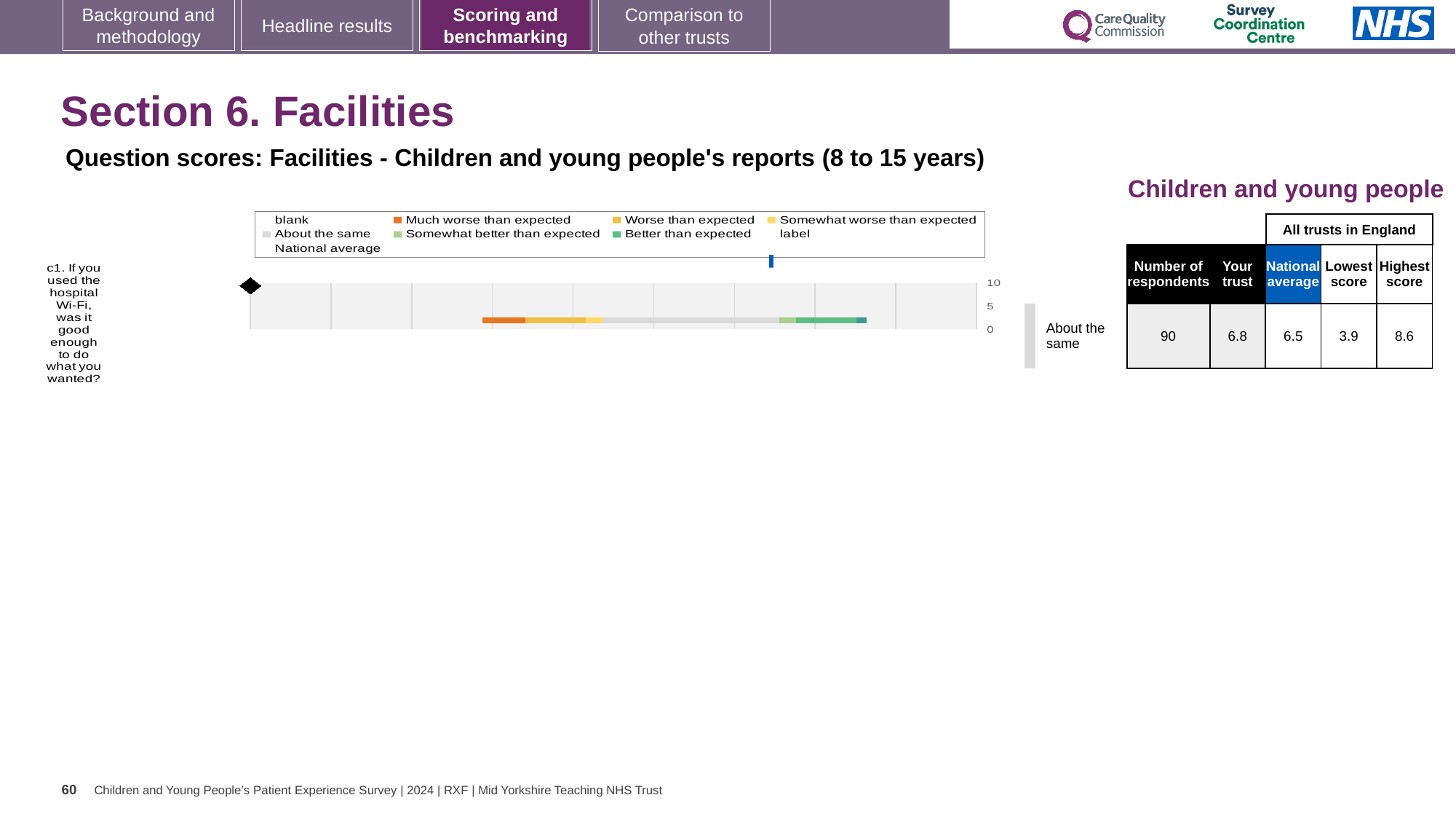
According to the table beside the chart, what is the 'Your trust' score for c1? 6.8 Which legend entry is shown in orange? Much worse than expected Which is larger for c1: the 'Your trust' score or the national average? Your trust What is the highest tick value shown on the chart's score axis? 10 Which benchmark category is the trust's result for c1 placed in? About the same According to the table beside the chart, what is the lowest score among all trusts in England for c1? 3.9 What kind of chart is used to show the question score for c1? bar chart What is the label of the question plotted on the chart? c1. If you used the hospital Wi-Fi, was it good enough to do what you wanted? According to the table beside the chart, how many respondents answered c1? 90 According to the table beside the chart, what is the national average score for c1? 6.5 According to the table beside the chart, what is the highest score among all trusts in England for c1? 8.6 How many survey questions are plotted on the chart? 1